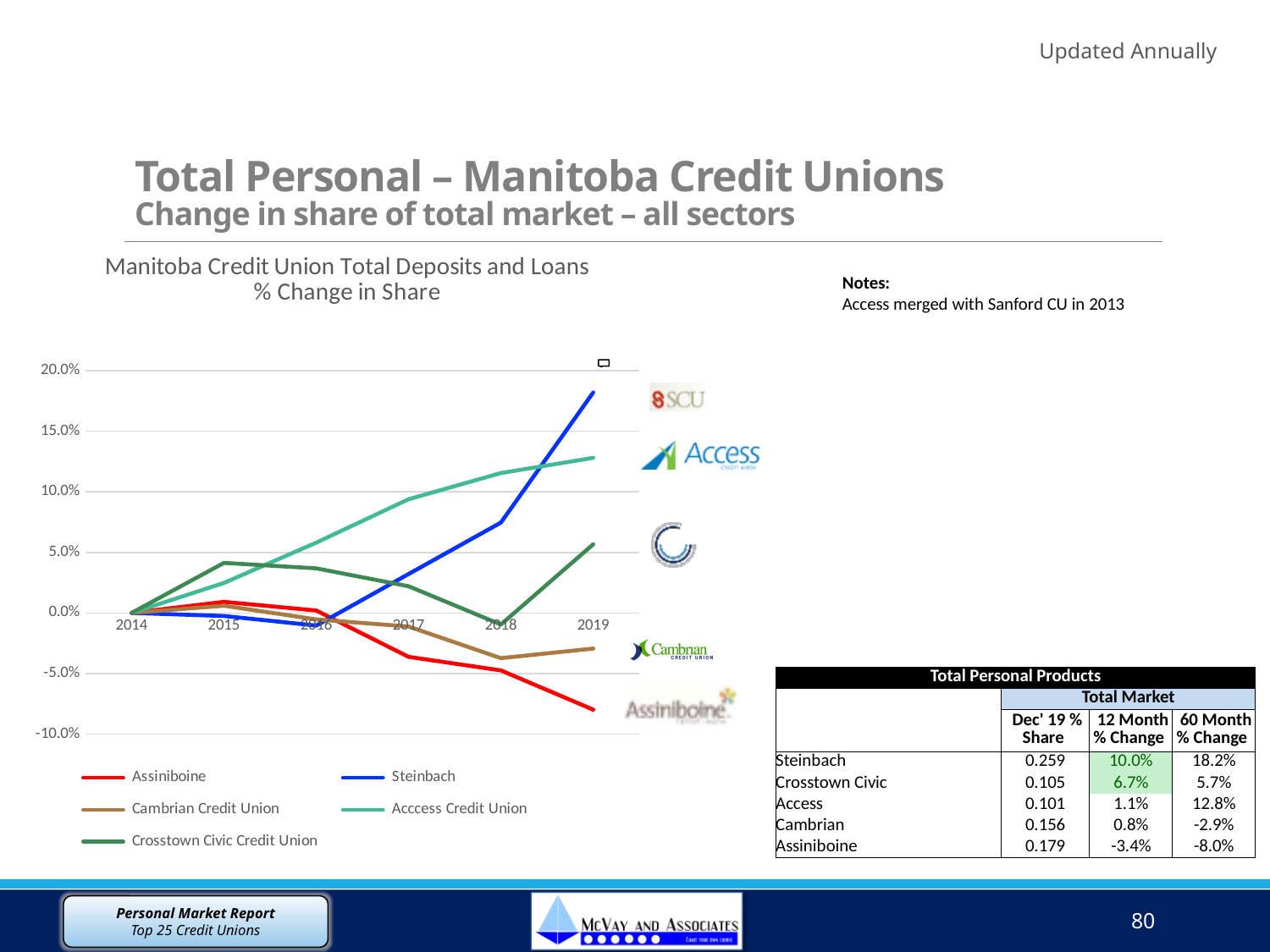
How many series does the chart legend list? 5 Which is larger in 2017, the value for Access Credit Union or the value for Crosstown Civic Credit Union? Access Credit Union Does the Assiniboine line rise or fall from 2015 to 2019? fall What is the title of the chart? Manitoba Credit Union Total Deposits and Loans % Change in Share Is the value for Steinbach in 2019 greater or less than 15.0%? greater How many years are shown along the x axis of the chart? 6 Which credit union has the lowest % change in share in 2019? Assiniboine Which credit union has the highest % change in share in 2019? Steinbach Does the Steinbach line rise or fall from 2016 to 2019? rise Is the value for Access Credit Union in 2019 greater or less than 10.0%? greater What kind of chart is shown on the slide? line chart Is the value for Assiniboine in 2019 greater or less than -5.0%? less